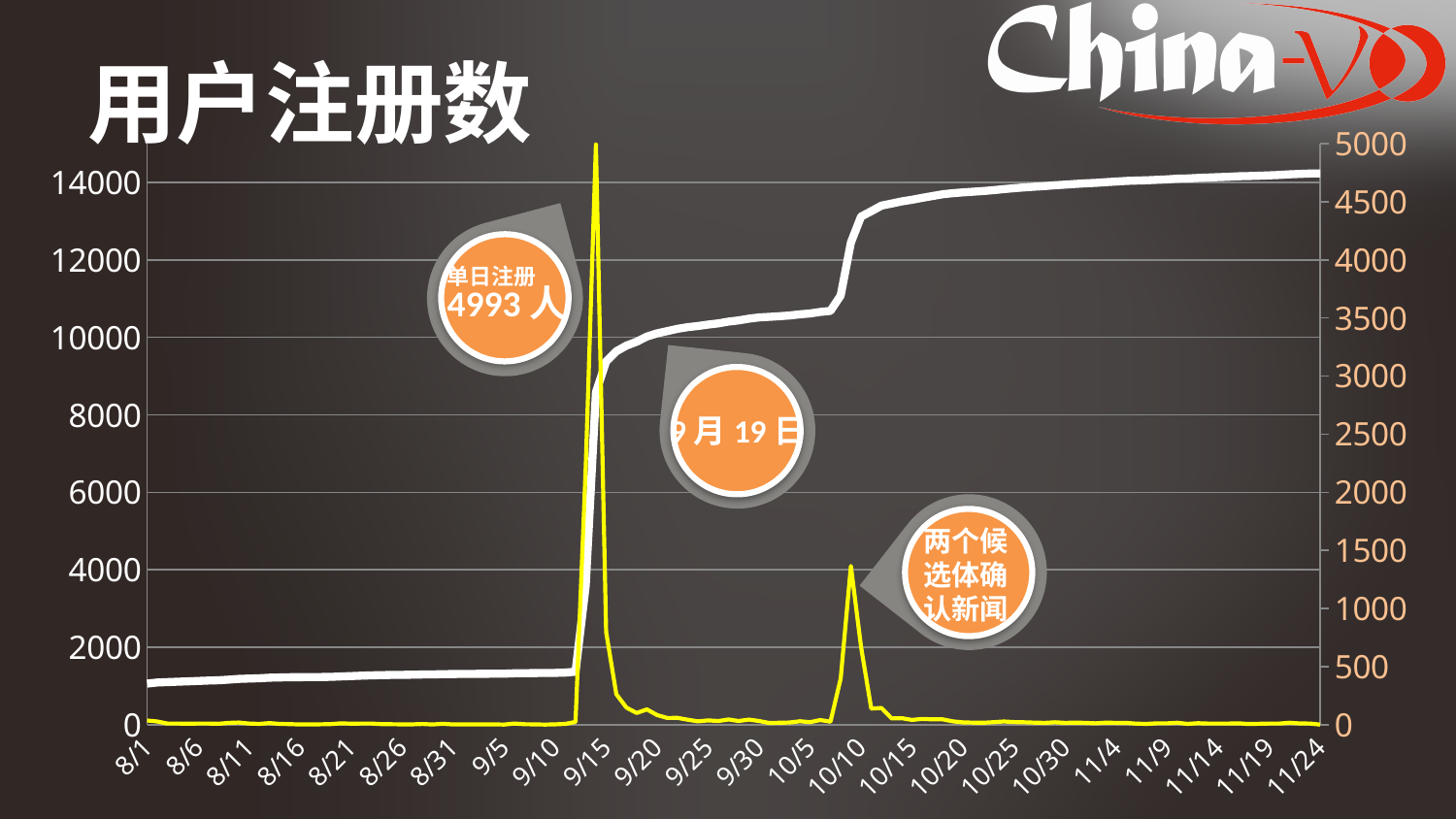
Is the value of the white line at 10/5 greater or less than 10000 on the left axis? greater Is the value of the white line at 8/1 greater or less than 2000 on the left axis? less What colour is the line that shows the sharp spike near 9/15? yellow Is the second peak of the yellow line, near 10/10, greater or less than 1000 on the right axis? greater According to the callout on the chart, what was the peak single-day registration count (单日注册)? 4993 人 What kind of chart is shown on the slide? line chart How many lines are plotted on the chart? 2 What is the title of the chart? 用户注册数 Does the white line rise or fall from 8/1 to 11/24? rise How many date labels are shown on the x axis? 24